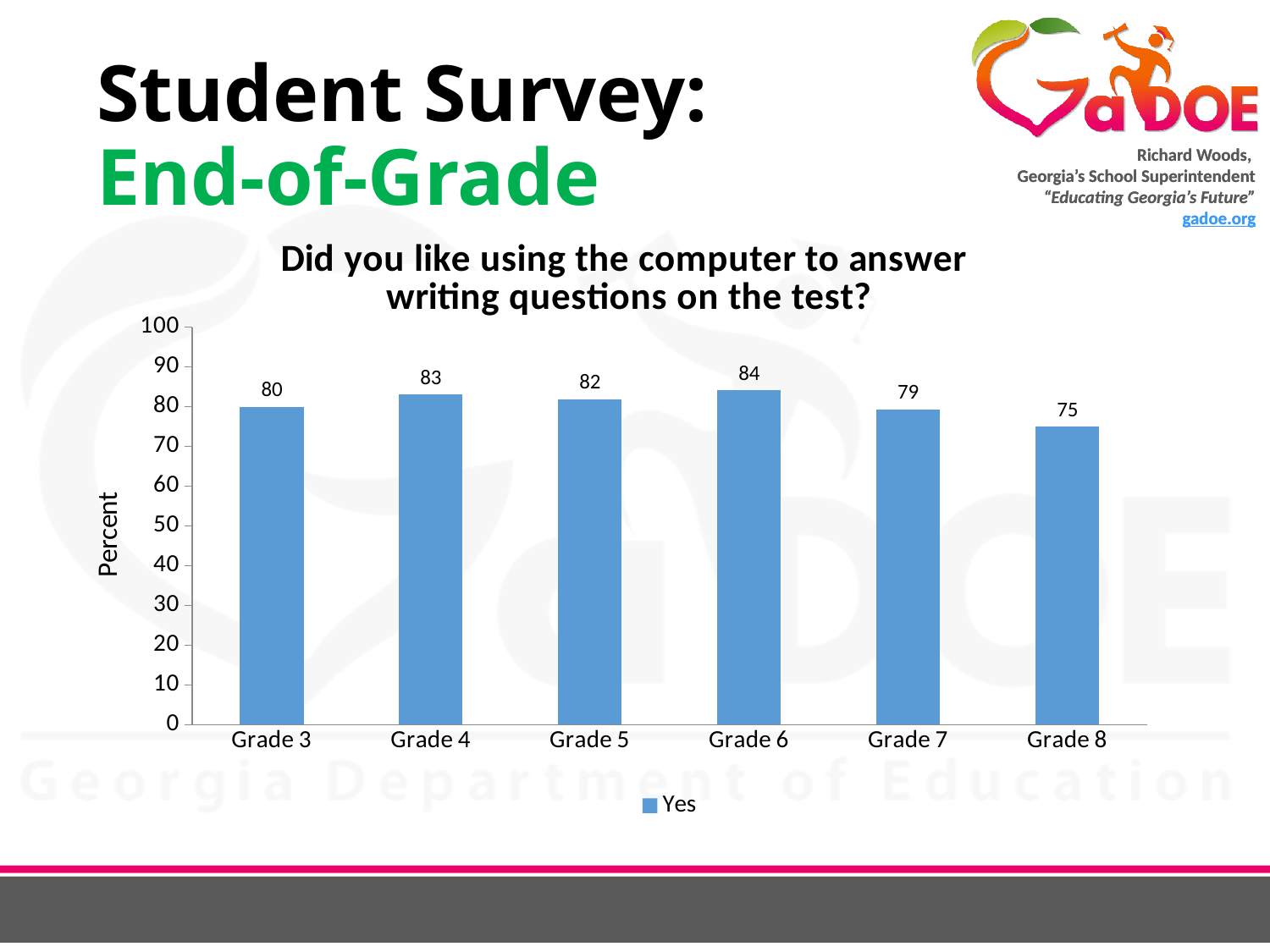
What is the label on the y axis of the chart? Percent What is the difference between the values for Grade 6 and Grade 8? 9 What is the value for Grade 8? 75 What is the difference between the values for Grade 4 and Grade 7? 4 What is the value for Grade 6? 84 What is the value for Grade 3? 80 How many grades are shown on the x axis? 6 Is the value for Grade 8 greater or less than 80? less Which is larger, the value for Grade 4 or the value for Grade 7? Grade 4 What kind of chart is shown on the slide? bar chart Which grade has the lowest value? Grade 8 Which grade has the highest value? Grade 6